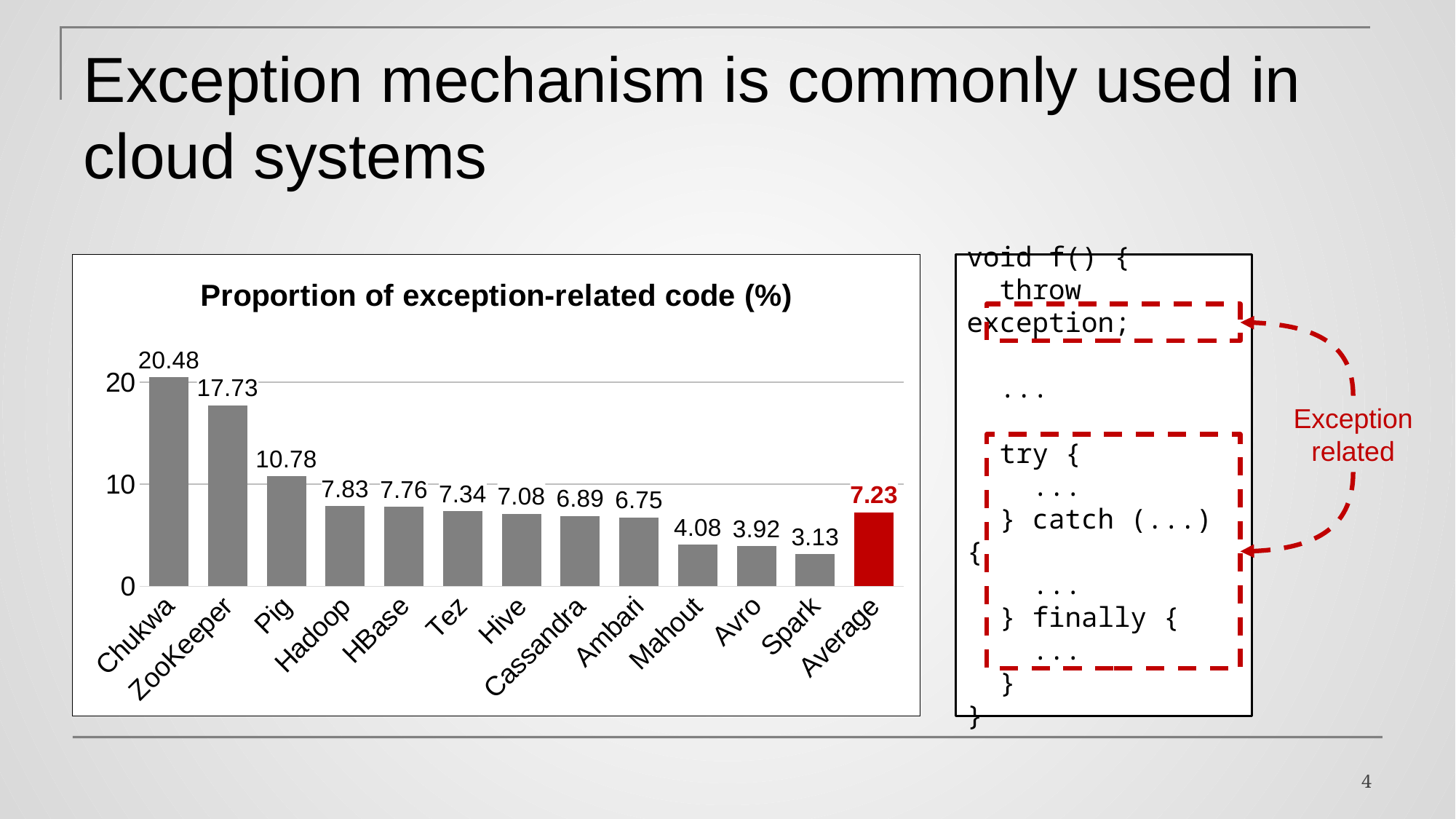
What is the title of the chart? Proportion of exception-related code (%) What is the value for Hadoop? 7.83 Which system has the highest proportion of exception-related code? Chukwa How many systems (excluding Average) are shown on the x axis? 12 What is the value shown for Average? 7.23 Which system has the lowest proportion of exception-related code? Spark What is the difference between the values for Chukwa and ZooKeeper? 2.75 What kind of chart is shown on the slide? bar chart What is the value for Chukwa? 20.48 Do the values rise or fall from Chukwa to Spark along the x axis? fall Which has a larger value, Pig or Mahout? Pig Is the value for ZooKeeper greater or less than 10? greater